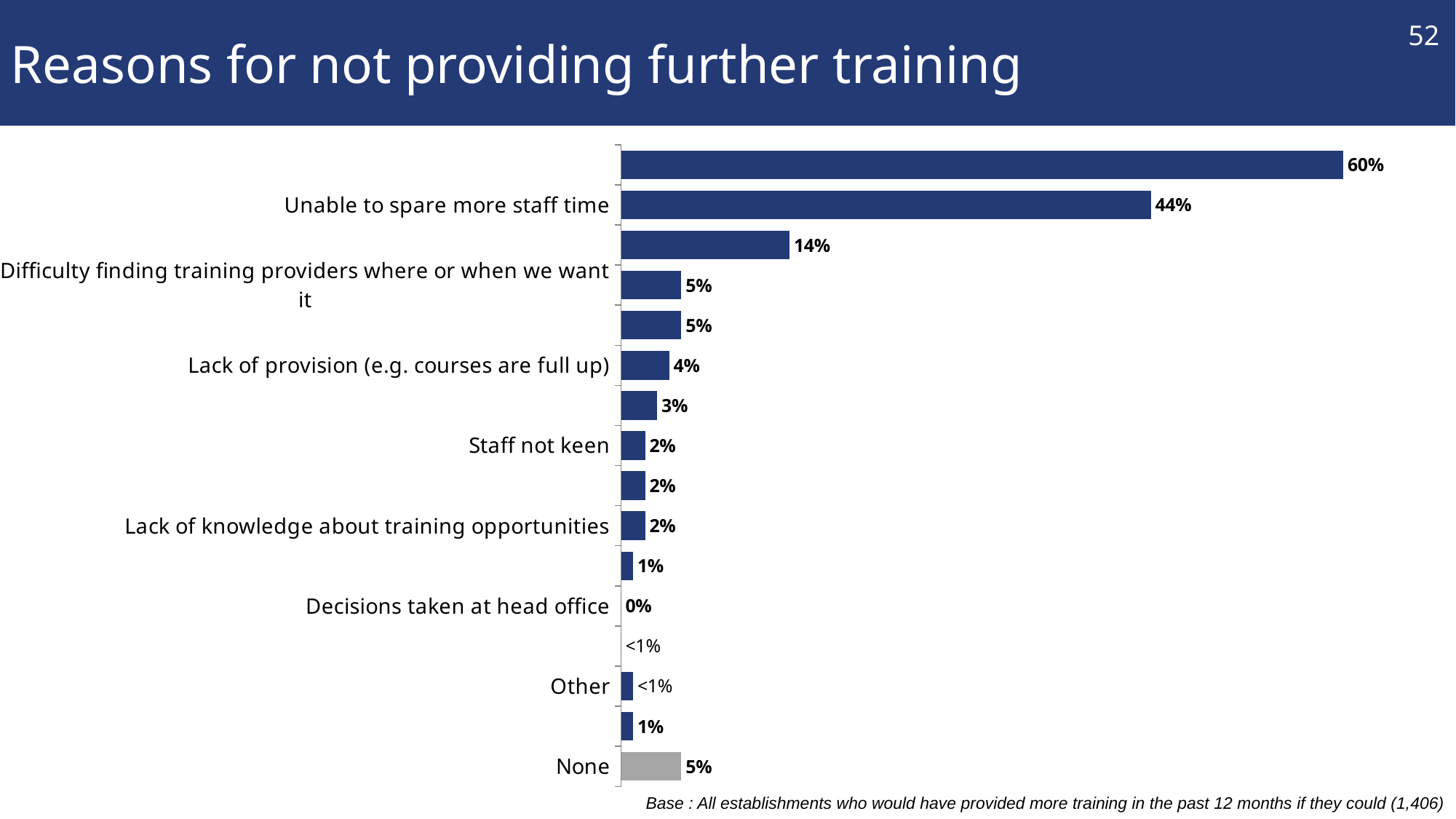
What is the value for "Difficulty finding training providers where or when we want it"? 5% What is the value for "Unable to spare more staff time"? 44% What is the value for "Other"? <1% Which is larger, the value for "Difficulty finding training providers where or when we want it" or the value for "Lack of provision (e.g. courses are full up)"? Difficulty finding training providers where or when we want it What is the highest value shown on the chart? 60% What is the value for "None"? 5% What is the value for "Lack of provision (e.g. courses are full up)"? 4% What is the value for "Decisions taken at head office"? 0% Which of the labelled categories has the lowest value? Decisions taken at head office What kind of chart is shown on the slide? Bar chart What is the difference between the values for "Unable to spare more staff time" and "Lack of provision (e.g. courses are full up)"? 40 percentage points What is the value for "Staff not keen"? 2%